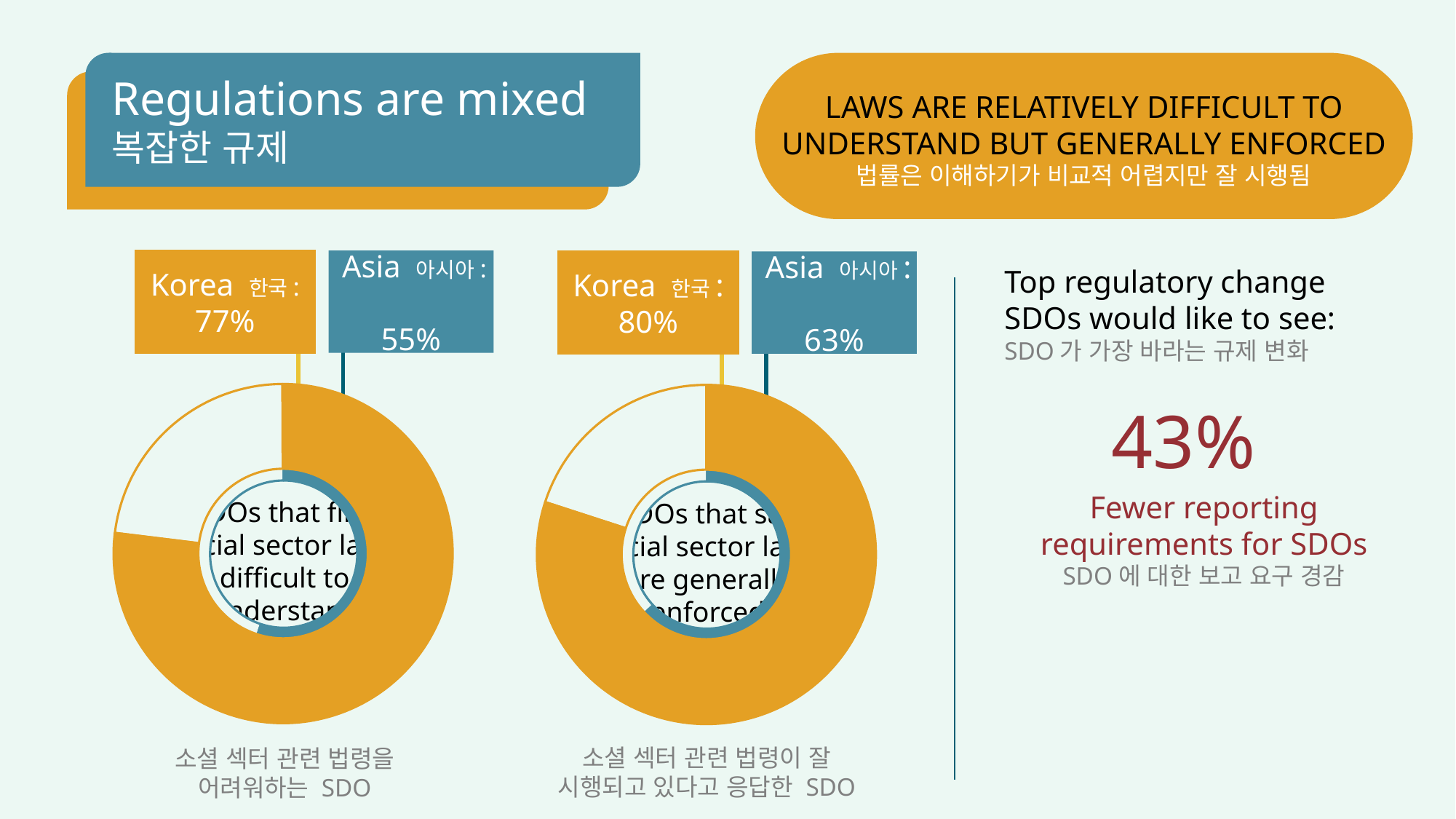
In the left donut chart, what is the difference between the Korea and Asia values? 22% In the left donut chart, what is the value for Asia? 55% How many donut charts are shown on the slide? 4 In the left donut chart, what is the value for Korea? 77% What type of chart is used on the left side of the slide? Donut chart In the right donut chart, what is the difference between the Korea and Asia values? 17% In the right donut chart, what colour is the Asia label box? Teal blue In the left donut chart, what colour is the Korea label box? Orange In the right donut chart, what is the value for Asia? 63% In the right donut chart, what is the value for Korea? 80% In the left donut chart, which is higher, Korea or Asia? Korea In the right donut chart, which is lower, Korea or Asia? Asia